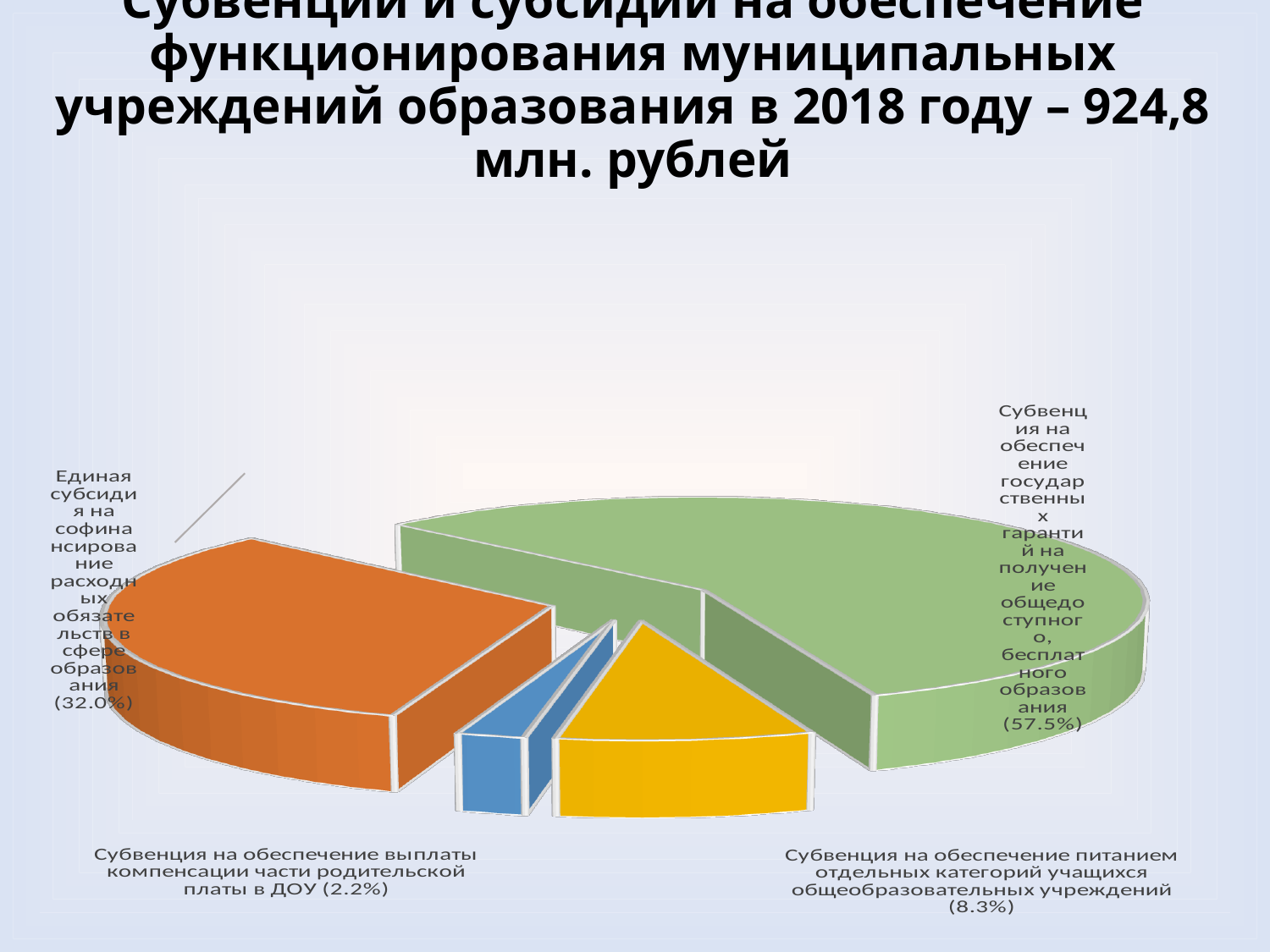
Каким цветом показан сектор субвенции на обеспечение питанием отдельных категорий учащихся? жёлтым Какой тип диаграммы показан на слайде? круговая диаграмма Сколько секторов (категорий) на круговой диаграмме? 4 Какая доля приходится на субвенцию на обеспечение выплаты компенсации части родительской платы в ДОУ? 2.2% Какая категория занимает наименьшую долю на диаграмме? Субвенция на обеспечение выплаты компенсации части родительской платы в ДОУ На сколько процентных пунктов доля субвенции на обеспечение государственных гарантий (57.5%) больше доли единой субсидии на софинансирование (32.0%)? 25.5 Какая доля приходится на субвенцию на обеспечение питанием отдельных категорий учащихся общеобразовательных учреждений? 8.3% Какая общая сумма субвенций и субсидий в 2018 году указана в заголовке слайда? 924,8 млн. рублей Какая доля приходится на субвенцию на обеспечение государственных гарантий на получение общедоступного, бесплатного образования? 57.5% Какая категория занимает наибольшую долю на диаграмме? Субвенция на обеспечение государственных гарантий на получение общедоступного, бесплатного образования Что больше: доля субвенции на обеспечение питанием учащихся или доля субвенции на компенсацию части родительской платы в ДОУ? доля субвенции на обеспечение питанием учащихся